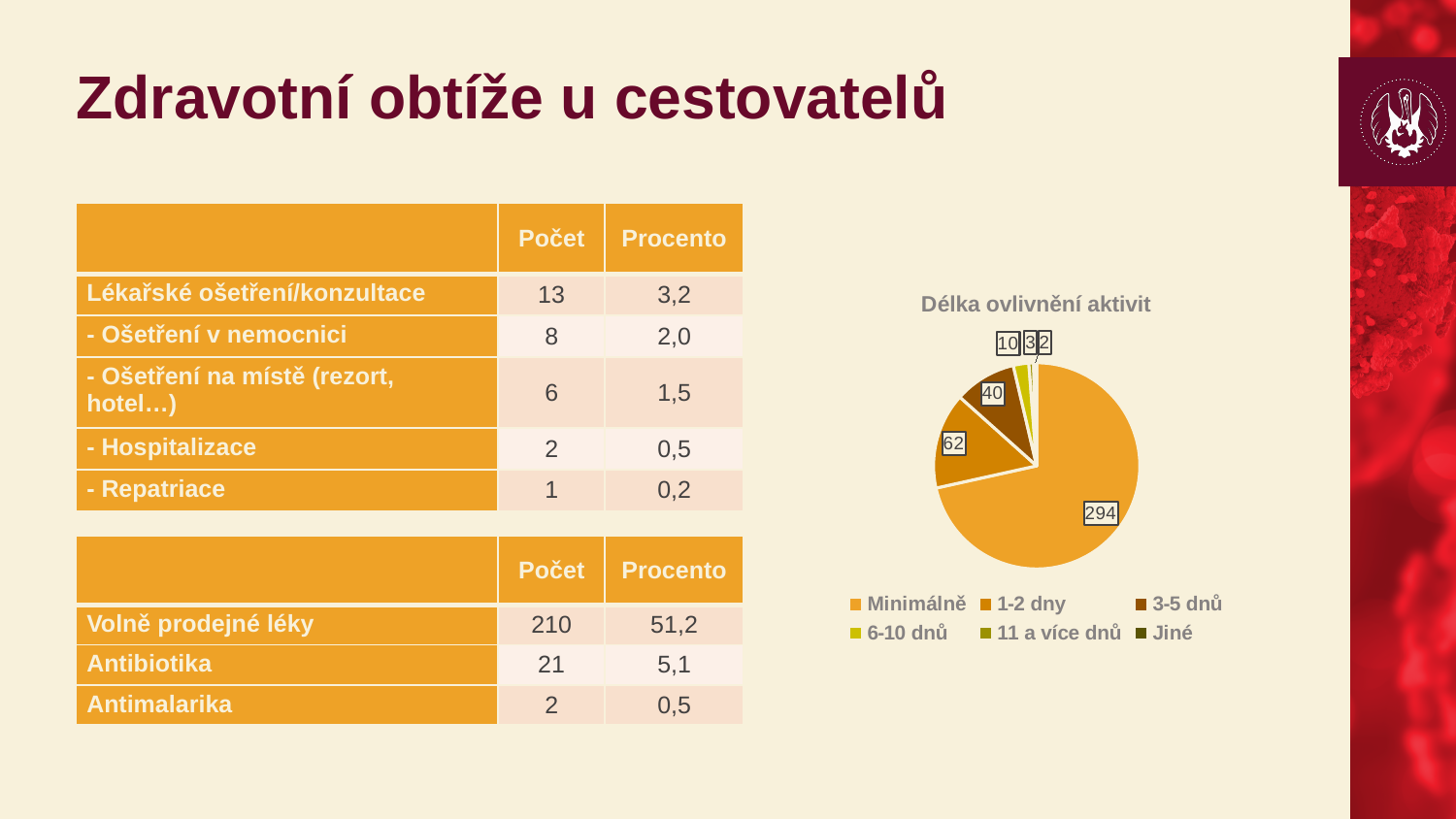
What is the value for the '1-2 dny' slice in the pie chart? 62 What is the value for the '6-10 dnů' slice in the pie chart? 10 Which category has the largest slice in the pie chart? Minimálně What is the difference between the '1-2 dny' and '3-5 dnů' values in the pie chart? 22 What type of chart is shown on the slide? pie chart What is the difference between the 'Minimálně' and '1-2 dny' values in the pie chart? 232 What is the title of the pie chart? Délka ovlivnění aktivit How many entries does the legend of the pie chart list? 6 What is the value for the 'Minimálně' slice in the pie chart? 294 What is the total of all the values labelled in the pie chart? 411 What is the value for the '3-5 dnů' slice in the pie chart? 40 Which is larger in the pie chart, '1-2 dny' or '3-5 dnů'? 1-2 dny